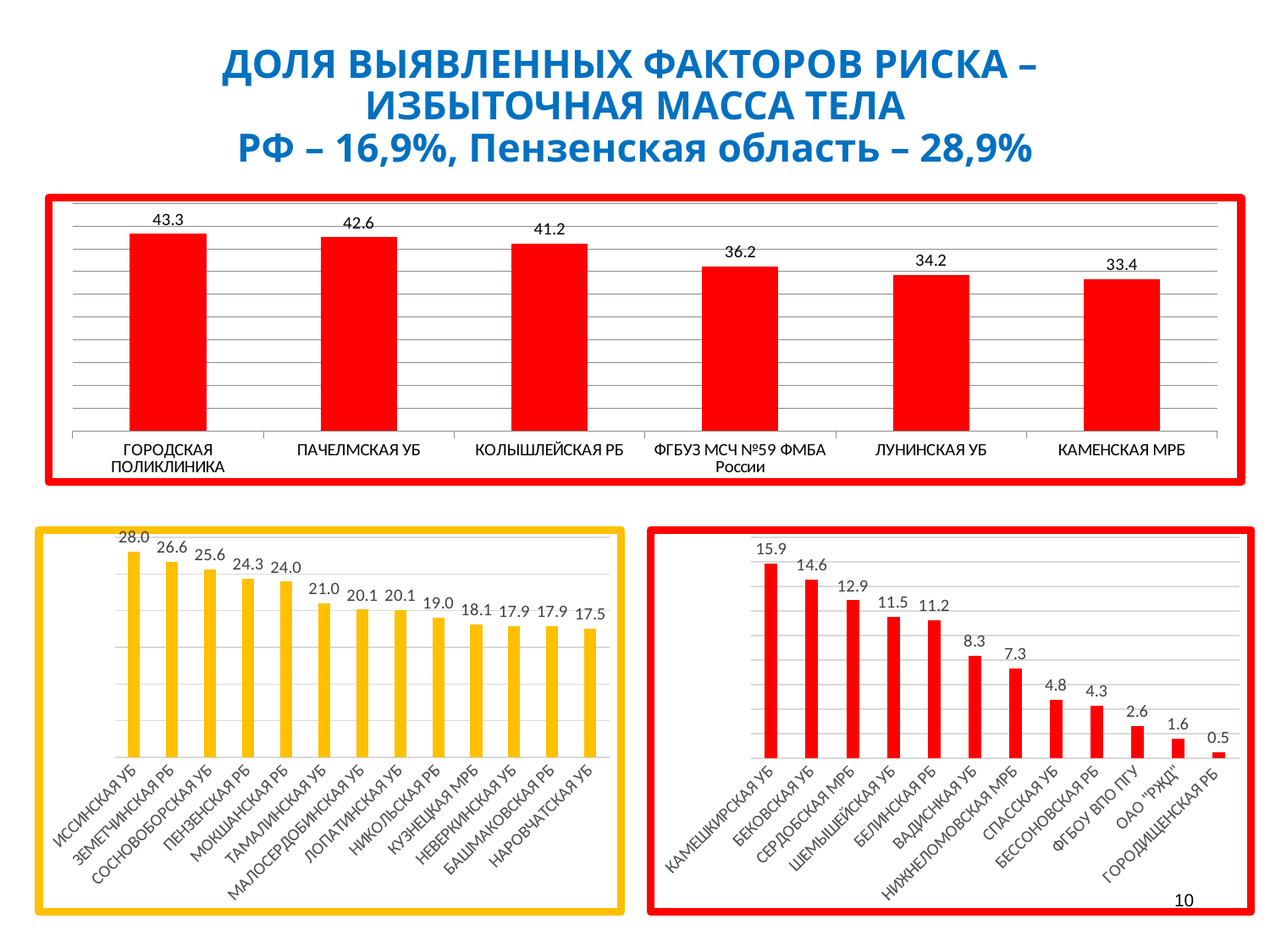
In the bottom-left chart, which category has the highest value? ИССИНСКАЯ УБ In the bottom-right chart, which is larger: СЕРДОБСКАЯ МРБ or СПАССКАЯ УБ? СЕРДОБСКАЯ МРБ In the bottom-right chart, what is the value for ВАДИНСКАЯ УБ? 8.3 In the top chart, how many categories are shown? 6 What kind of chart is the bottom-right chart? bar chart In the bottom-right chart, which category has the lowest value? ГОРОДИЩЕНСКАЯ РБ In the top chart, which category has the lowest value? КАМЕНСКАЯ МРБ In the bottom-left chart, what is the value for МОКШАНСКАЯ РБ? 24.0 In the top chart, what is the difference between ГОРОДСКАЯ ПОЛИКЛИНИКА and ФГБУЗ МСЧ №59 ФМБА России? 7.1 In the top chart, what is the value for ПАЧЕЛМСКАЯ УБ? 42.6 In the bottom-left chart, do the values rise or fall from left to right? fall In the bottom-left chart, how many categories are shown? 13